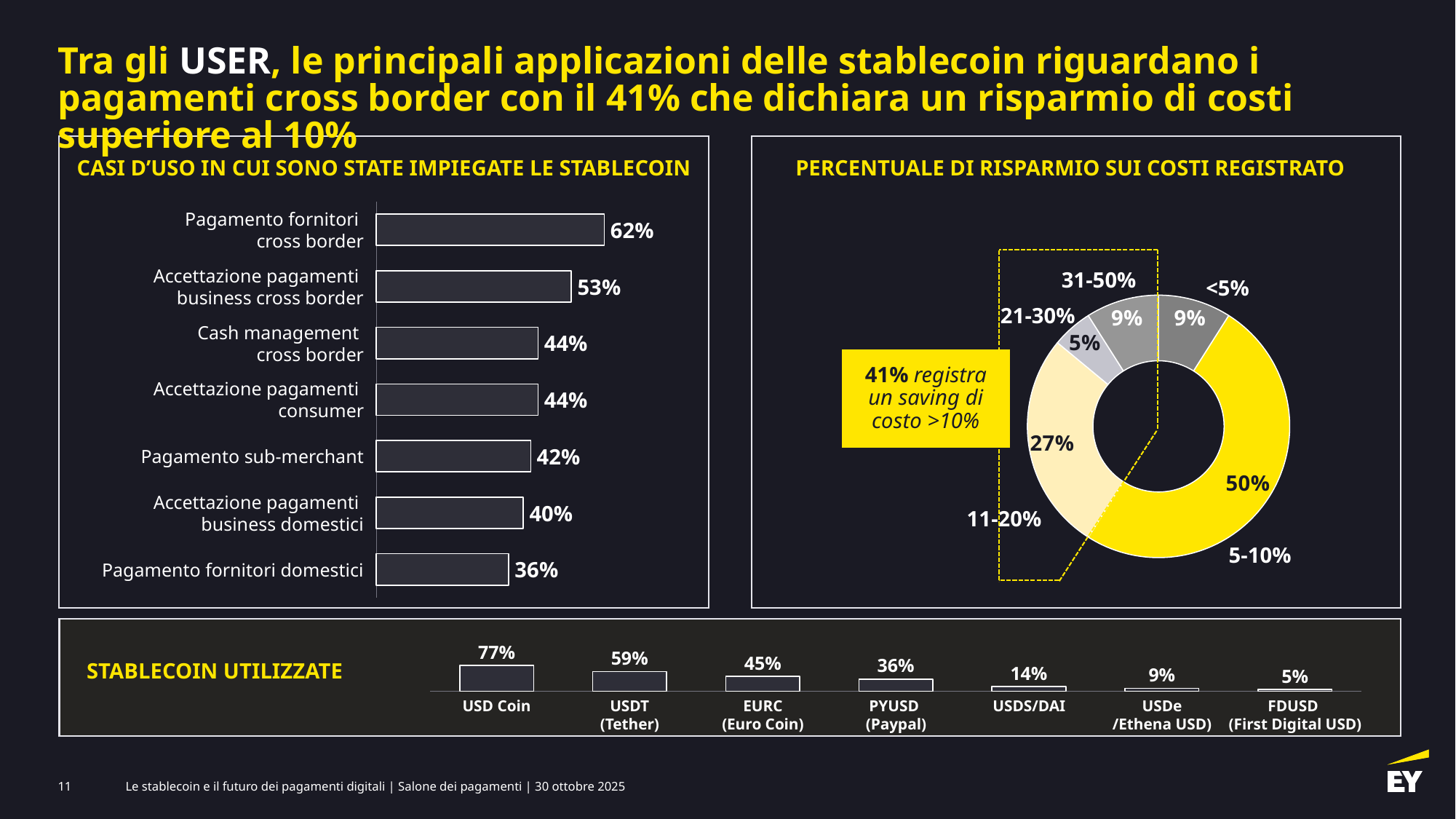
In the chart 'STABLECOIN UTILIZZATE', what is the value for 'USDT (Tether)'? 59% In the chart 'STABLECOIN UTILIZZATE', do the values rise or fall from left to right? Fall What kind of chart is 'CASI D'USO IN CUI SONO STATE IMPIEGATE LE STABLECOIN'? Bar chart In the chart 'CASI D'USO IN CUI SONO STATE IMPIEGATE LE STABLECOIN', what is the value for 'Pagamento fornitori cross border'? 62% In the chart 'CASI D'USO IN CUI SONO STATE IMPIEGATE LE STABLECOIN', what is the difference between 'Pagamento fornitori cross border' and 'Accettazione pagamenti business cross border'? 9% In the chart 'CASI D'USO IN CUI SONO STATE IMPIEGATE LE STABLECOIN', how many categories are shown? 7 In the chart 'PERCENTUALE DI RISPARMIO SUI COSTI REGISTRATO', how many slices are there? 5 In the chart 'PERCENTUALE DI RISPARMIO SUI COSTI REGISTRATO', what share does the '5-10%' slice have? 50% In the chart 'CASI D'USO IN CUI SONO STATE IMPIEGATE LE STABLECOIN', which category has the lowest value? Pagamento fornitori domestici In the chart 'PERCENTUALE DI RISPARMIO SUI COSTI REGISTRATO', which slice is the smallest? 21-30% In the chart 'STABLECOIN UTILIZZATE', which stablecoin has the highest value? USD Coin In the chart 'PERCENTUALE DI RISPARMIO SUI COSTI REGISTRATO', what is the value for '11-20%'? 27%